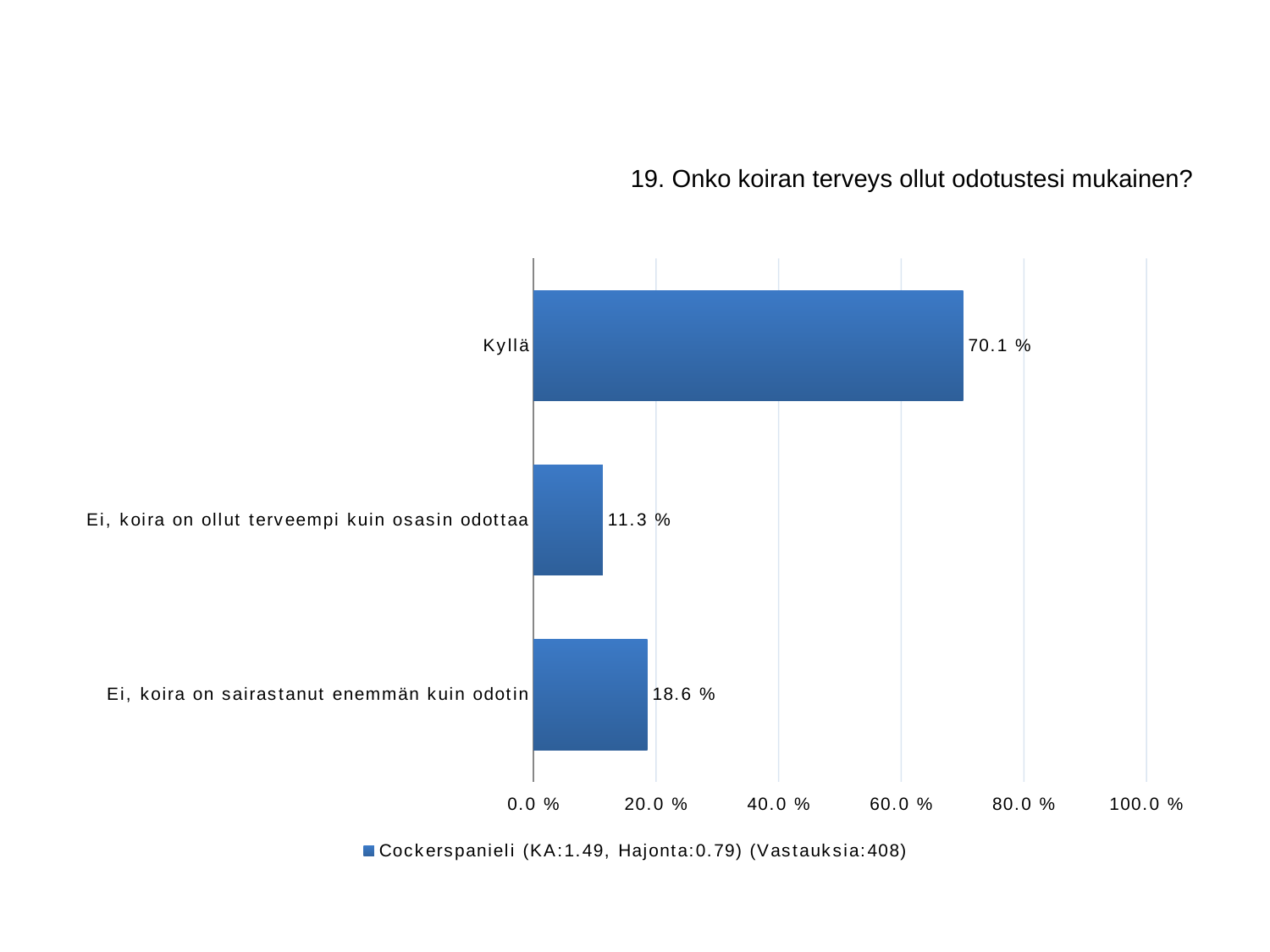
What is the difference between the values for "Kyllä" and "Ei, koira on sairastanut enemmän kuin odotin"? 51.5 % What is the value for "Ei, koira on ollut terveempi kuin osasin odottaa"? 11.3 % Which category has the highest value? Kyllä Which category has the lowest value? Ei, koira on ollut terveempi kuin osasin odottaa What is the difference between the values for "Ei, koira on sairastanut enemmän kuin odotin" and "Ei, koira on ollut terveempi kuin osasin odottaa"? 7.3 % What is the value for "Ei, koira on sairastanut enemmän kuin odotin"? 18.6 % What kind of chart is shown on the slide? bar chart Which is larger: the value for "Ei, koira on ollut terveempi kuin osasin odottaa" or "Ei, koira on sairastanut enemmän kuin odotin"? Ei, koira on sairastanut enemmän kuin odotin Is the value for "Kyllä" greater or less than 60.0 %? greater What is the value for "Kyllä"? 70.1 % How many categories are shown in the chart? 3 What is the title of the chart? 19. Onko koiran terveys ollut odotustesi mukainen?